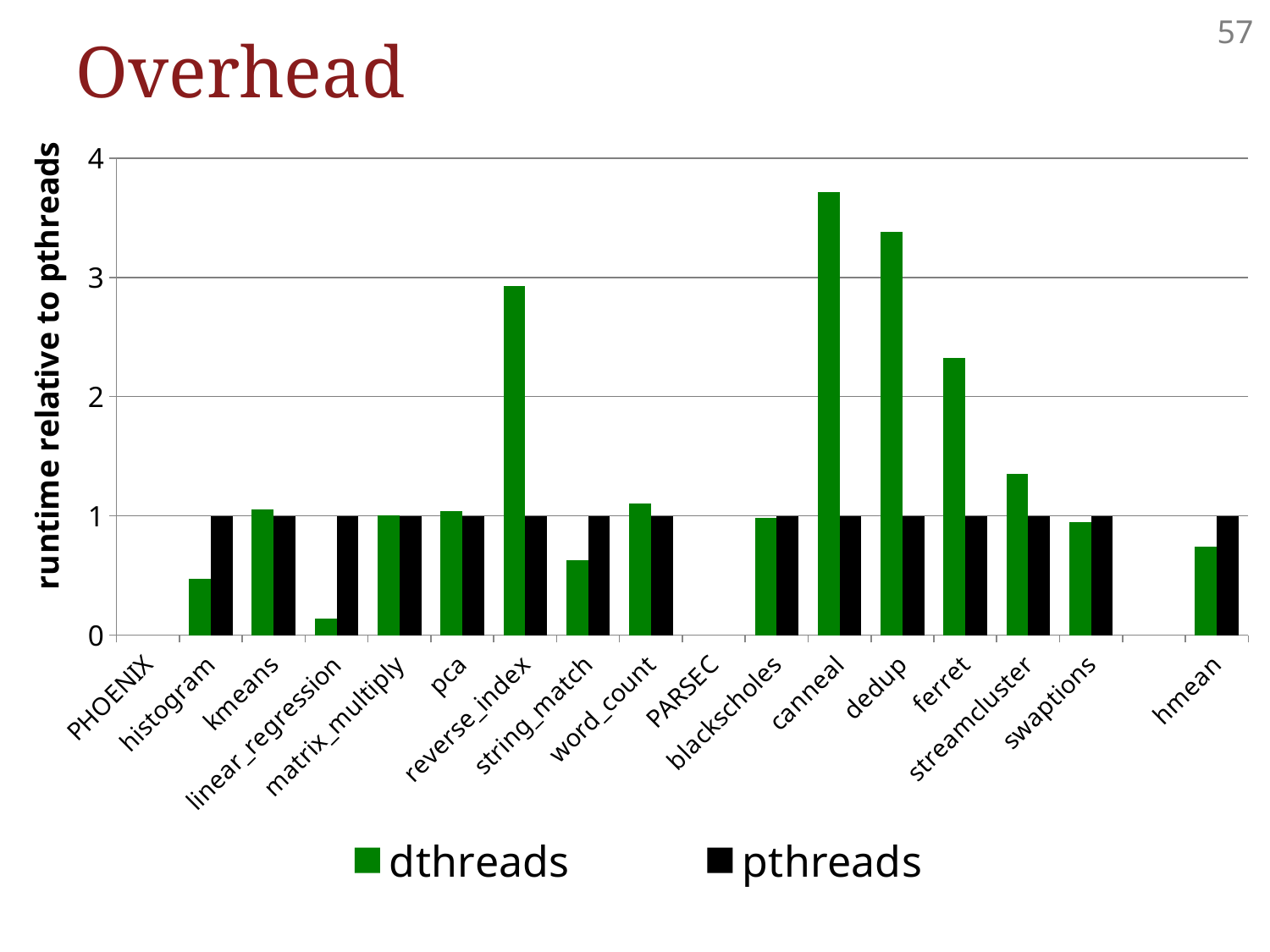
Is the dthreads value for hmean greater or less than 1? less What is the label of the y axis? runtime relative to pthreads How many series does the legend list? 2 Which has the larger dthreads value, canneal or dedup? canneal Is the dthreads value for histogram greater or less than 1? less What is the pthreads value for blackscholes? 1 What kind of chart is shown on the slide? bar chart Which has the larger dthreads value, ferret or streamcluster? ferret Which category has the lowest dthreads value? linear_regression Is the dthreads value for dedup greater or less than 3? greater Which category has the highest dthreads value? canneal